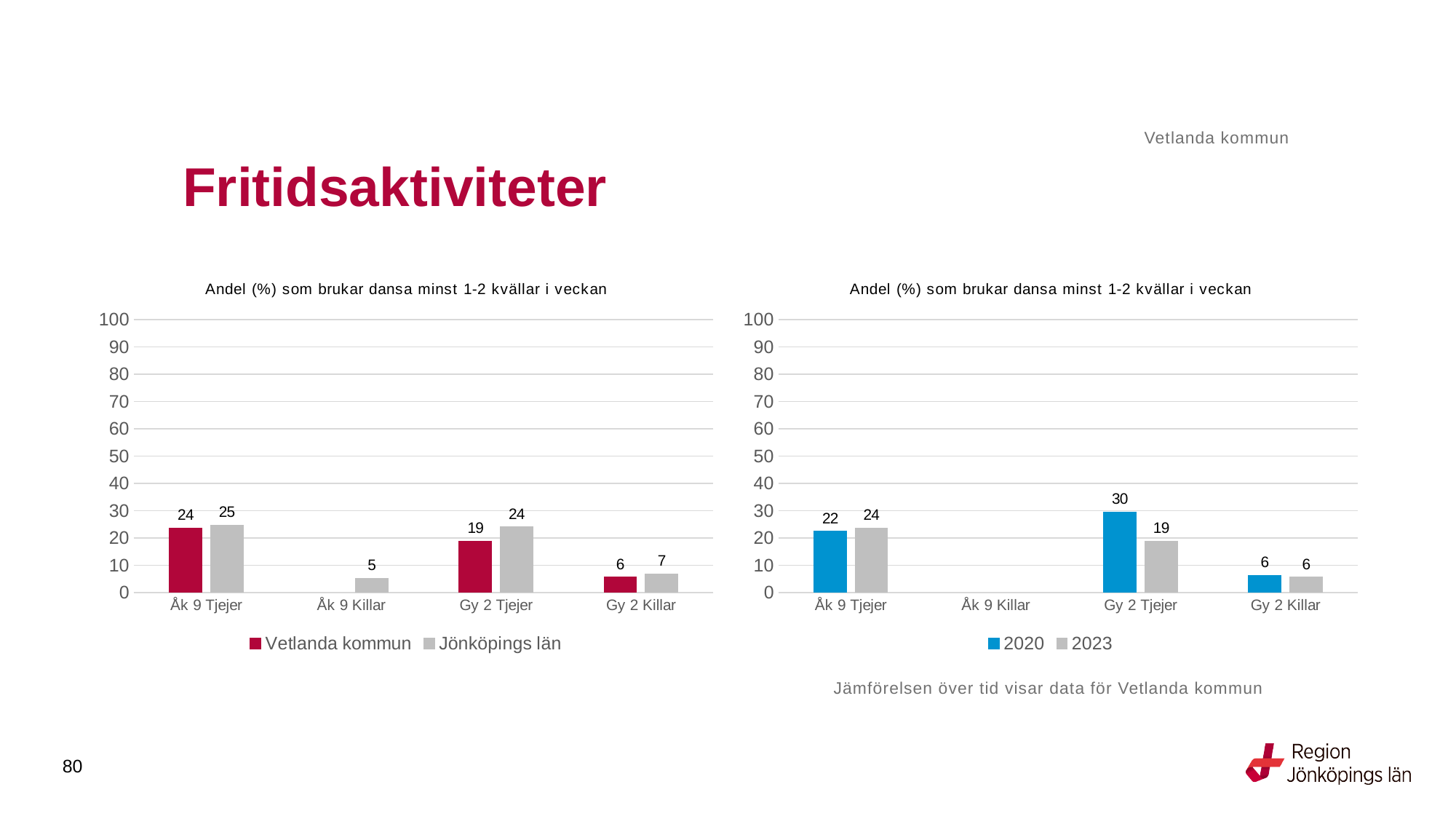
How many categories are shown on the x axis of the right chart? 4 In the right chart, which category has the highest value for 2020? Gy 2 Tjejer In the left chart, what is the value for Vetlanda kommun for Åk 9 Tjejer? 24 In the left chart, what is the value for Jönköpings län for Gy 2 Tjejer? 24 In the right chart, is the 2020 value for Gy 2 Tjejer larger or smaller than the 2023 value? larger In the right chart, what is the difference between the 2020 and 2023 values for Gy 2 Tjejer? 11 In the right chart, what is the value for 2023 for Åk 9 Tjejer? 24 In the left chart, what is the difference between Jönköpings län and Vetlanda kommun for Gy 2 Tjejer? 5 In the left chart, which category has the lowest value for Jönköpings län? Åk 9 Killar In the right chart, what is the value for 2020 for Gy 2 Tjejer? 30 What kind of chart is the left chart? bar chart In the left chart, how many series does the legend list? 2